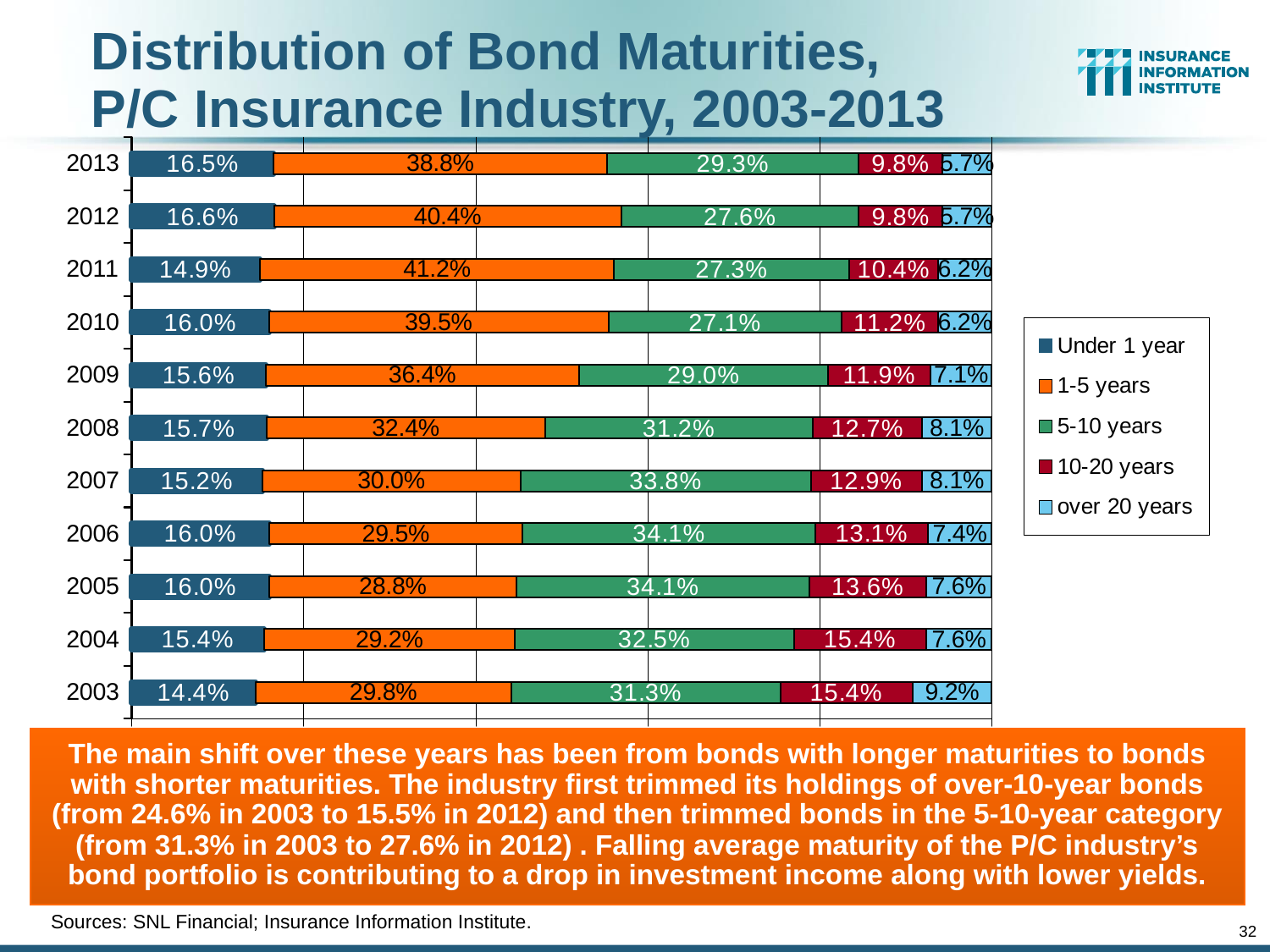
In which year was the 5-10 years share the lowest? 2010 What was the 5-10 years share in 2003? 31.3% What was the 10-20 years share in 2010? 11.2% How many years are shown on the chart? 11 Which is larger: the 10-20 years share in 2003 or in 2013? 2003 What share of bonds had maturities of 1-5 years in 2013? 38.8% What type of chart is shown? Stacked bar chart In which year was the 1-5 years share the highest? 2011 Did the over 20 years share rise or fall from 2003 to 2013? Fall By how many percentage points did the 1-5 years share in 2013 exceed that in 2003? 9.0 percentage points In which year was the over 20 years share the highest? 2003 How many maturity categories does the legend list? 5